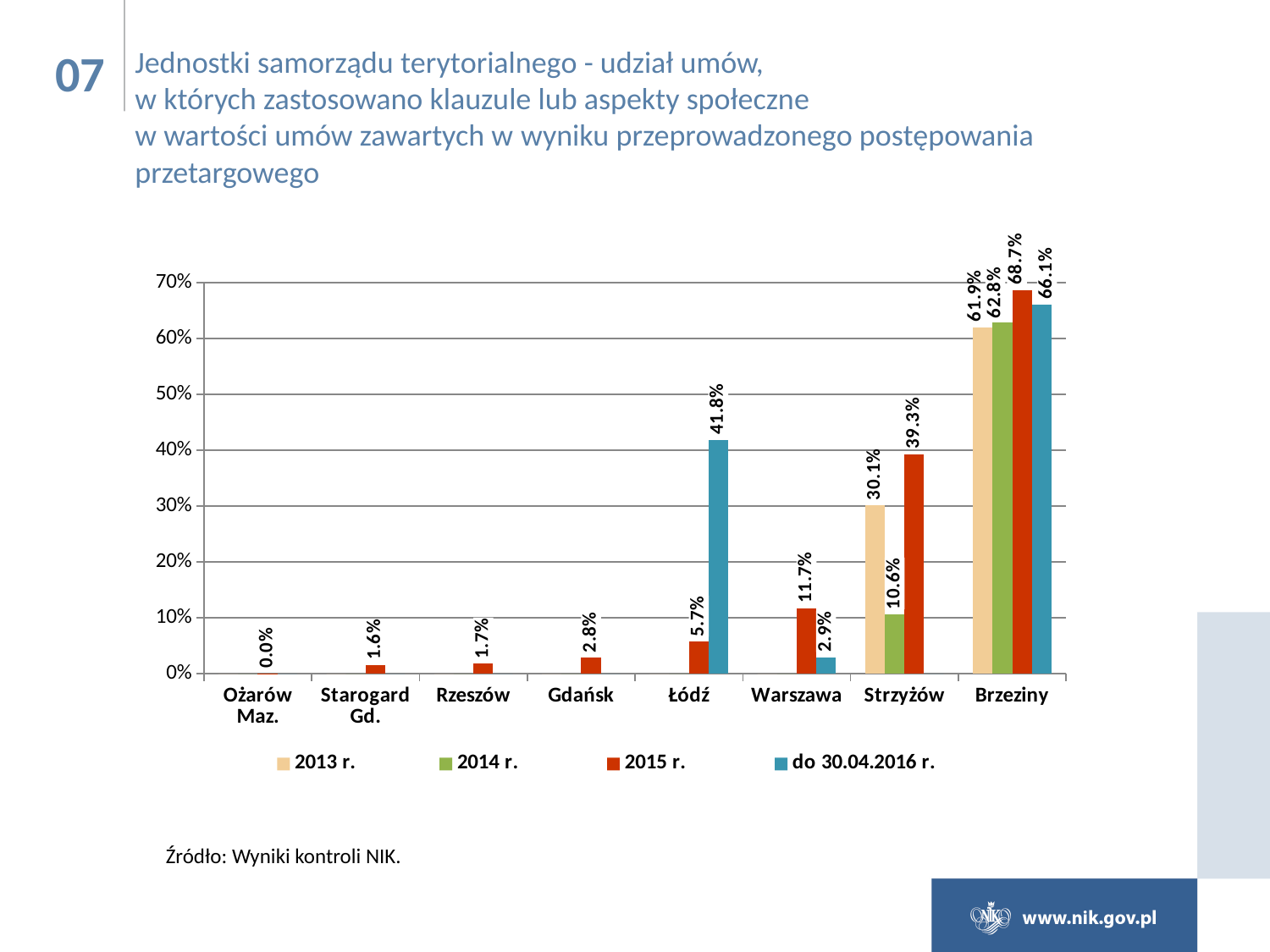
How many series does the legend list? 4 What is the value for Brzeziny in the 2015 r. series? 68.7% What is the difference between the 2015 r. value and the 2013 r. value for Strzyżów? 9.2% What is the value for Warszawa in the 2015 r. series? 11.7% What is the label of the last series in the legend? do 30.04.2016 r. What kind of chart is shown on the slide? Bar chart What is the value for Łódź in the 'do 30.04.2016 r.' series? 41.8% Which category has the highest value in the 2015 r. series? Brzeziny How many categories are shown on the x axis? 8 What is the value for Strzyżów in the 2014 r. series? 10.6% Which category has the lowest value in the 2015 r. series? Ożarów Maz. Which is larger for Warszawa: the 2015 r. value or the 'do 30.04.2016 r.' value? 2015 r.